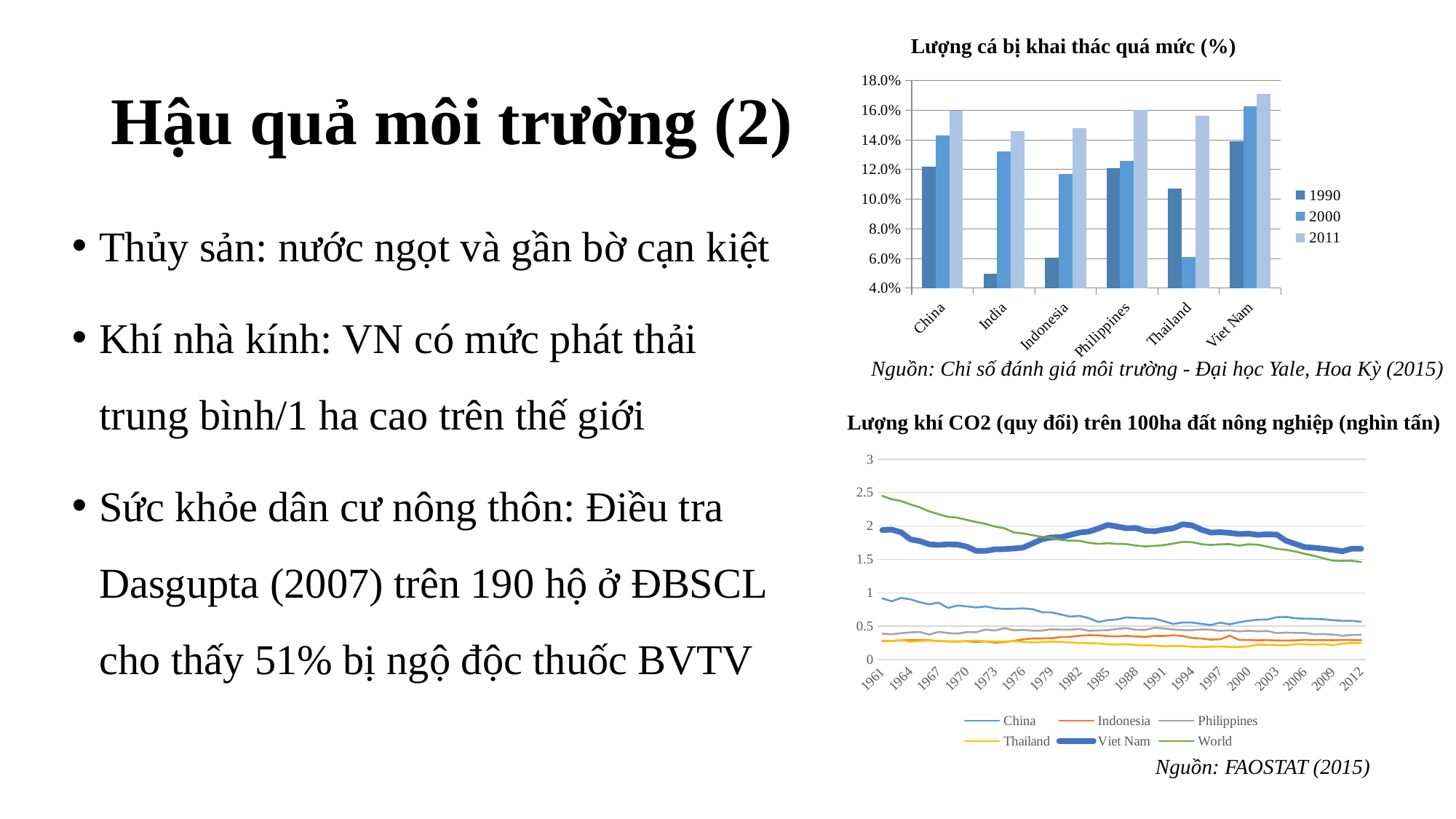
What kind of chart is the bottom chart titled 'Lượng khí CO2 (quy đổi) trên 100ha đất nông nghiệp (nghìn tấn)'? line chart In the top chart 'Lượng cá bị khai thác quá mức (%)', which country has the highest value for 2011? Viet Nam In the bottom chart 'Lượng khí CO2 (quy đổi) trên 100ha đất nông nghiệp (nghìn tấn)', does the World line rise or fall from 1961 to 2012? fall In the top chart 'Lượng cá bị khai thác quá mức (%)', which is larger for 1990: Thailand or Indonesia? Thailand In the top chart 'Lượng cá bị khai thác quá mức (%)', which country has the lowest value for 1990? India In the top chart 'Lượng cá bị khai thác quá mức (%)', is the 2011 value for Viet Nam greater or less than 16.0%? greater How many countries are shown on the x axis of the top chart 'Lượng cá bị khai thác quá mức (%)'? 6 In the bottom chart 'Lượng khí CO2 (quy đổi) trên 100ha đất nông nghiệp (nghìn tấn)', is the World value in 1961 greater or less than 2? greater How many series does the legend of the bottom chart 'Lượng khí CO2 (quy đổi) trên 100ha đất nông nghiệp (nghìn tấn)' list? 6 How many series does the legend of the top chart 'Lượng cá bị khai thác quá mức (%)' list? 3 In the top chart 'Lượng cá bị khai thác quá mức (%)', is the 1990 value for India greater or less than 6.0%? less What kind of chart is the top chart titled 'Lượng cá bị khai thác quá mức (%)'? bar chart